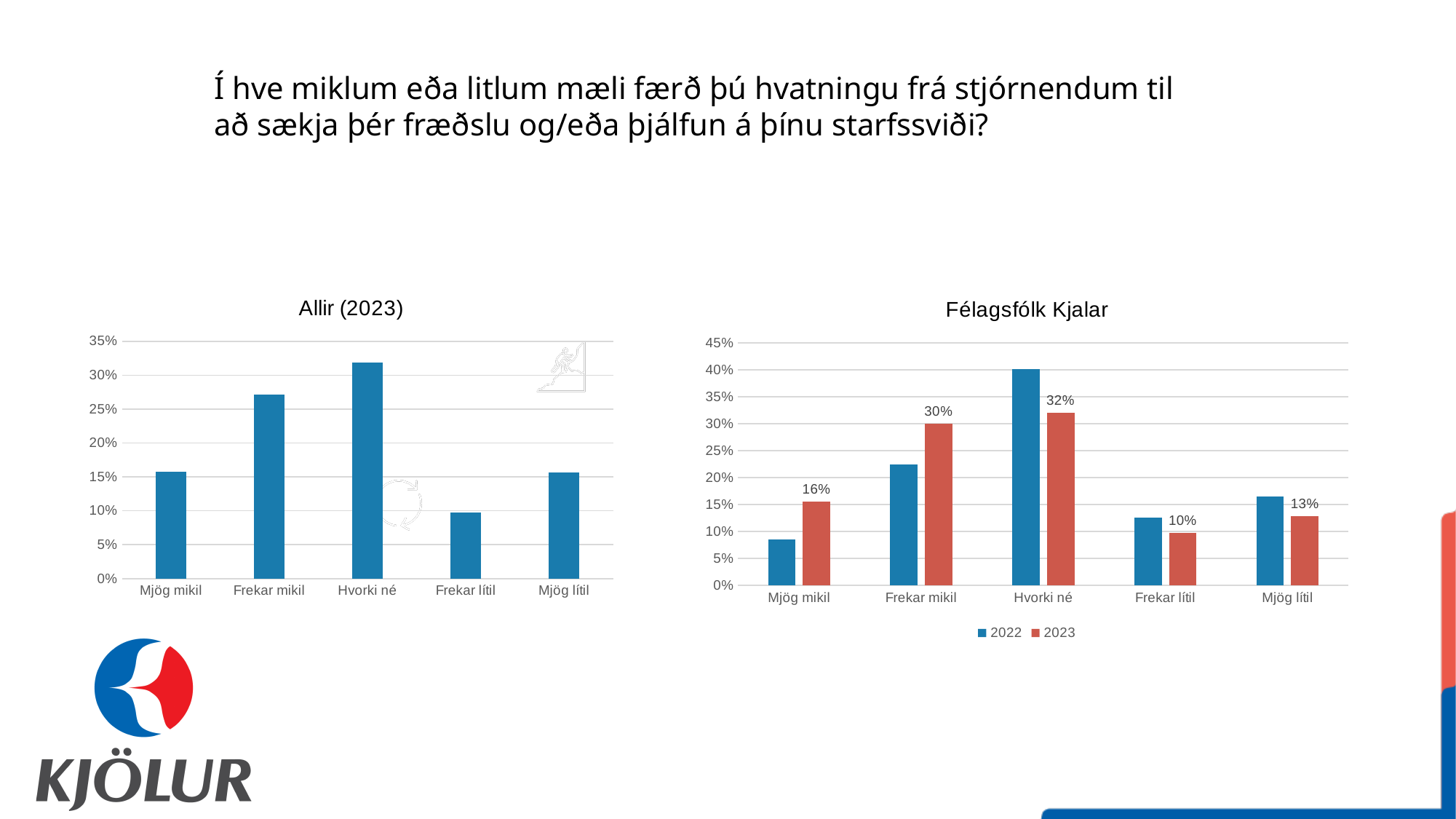
In the Allir (2023) chart, is the value for Frekar mikil greater or less than 25%? greater In the Félagsfólk Kjalar chart, what is the 2023 value for Mjög lítil? 13% In the Félagsfólk Kjalar chart, is the 2022 value for Hvorki né greater or less than 35%? greater In the Allir (2023) chart, which category has the highest value? Hvorki né In the Allir (2023) chart, which category has the lowest value? Frekar lítil How many series does the legend of the Félagsfólk Kjalar chart list? 2 In the Félagsfólk Kjalar chart, what is the 2023 value for Frekar mikil? 30% In the Félagsfólk Kjalar chart, is the 2022 value for Mjög mikil greater or less than 10%? less How many categories are shown on the x axis of the Allir (2023) chart? 5 In the Félagsfólk Kjalar chart, what is the difference between the 2023 values for Hvorki né and Mjög mikil? 16% In the Félagsfólk Kjalar chart, which category has the highest 2023 value? Hvorki né In the Félagsfólk Kjalar chart, which category has the lowest 2023 value? Frekar lítil